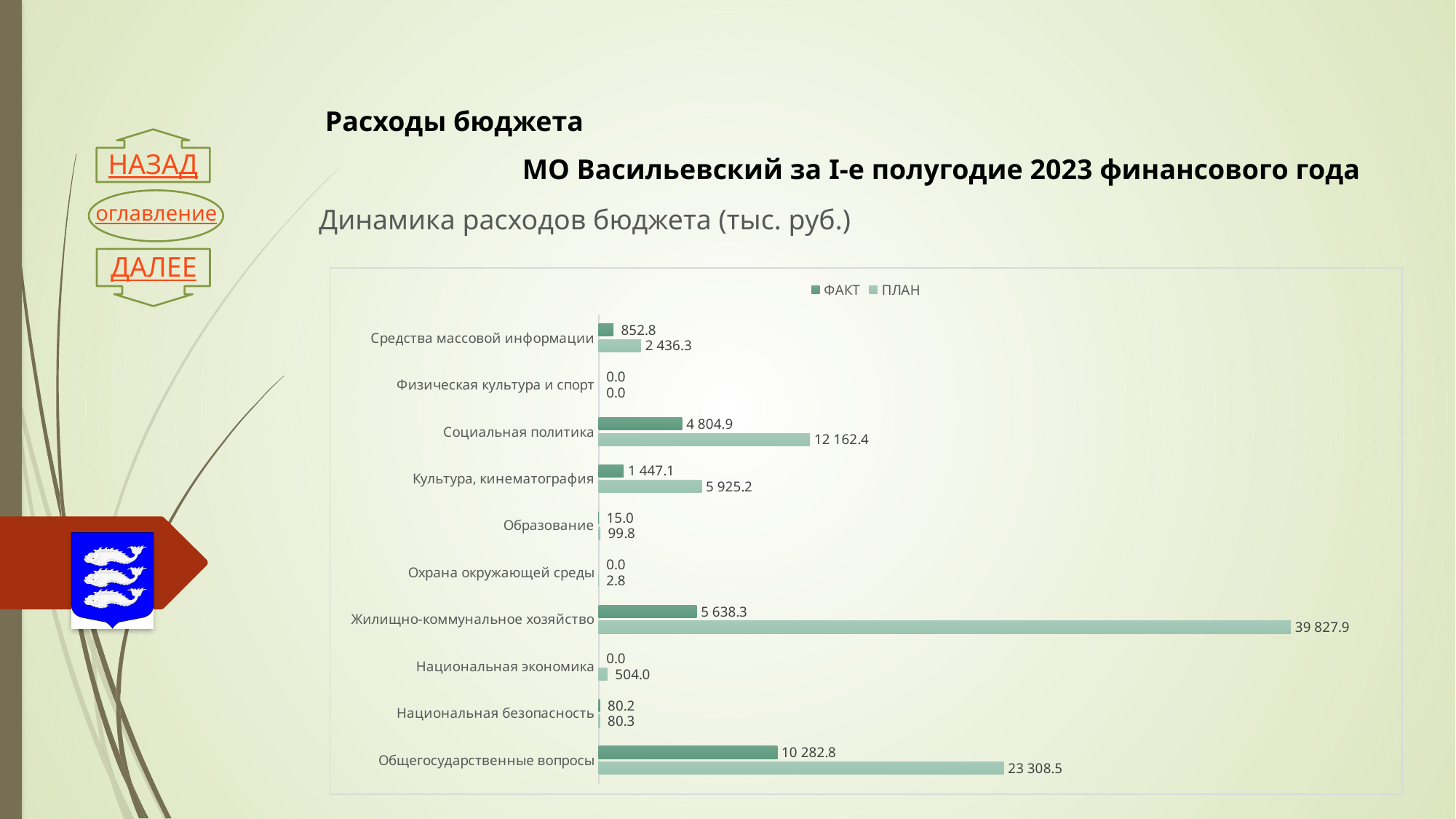
What is the difference between the ПЛАН and ФАКТ values for Социальная политика? 7 357.5 What is the ПЛАН value for Жилищно-коммунальное хозяйство? 39 827.9 Which is larger for Культура, кинематография: the ФАКТ value or the ПЛАН value? ПЛАН How many series does the legend list? 2 What is the ФАКТ value for Социальная политика? 4 804.9 What is the ПЛАН value for Средства массовой информации? 2 436.3 What is the ФАКТ value for Национальная безопасность? 80.2 What kind of chart is shown on the slide? Bar chart How many categories are shown in the chart? 10 Which category has the lowest ПЛАН value? Физическая культура и спорт Which category has the highest ФАКТ value? Общегосударственные вопросы Which category has the highest ПЛАН value? Жилищно-коммунальное хозяйство